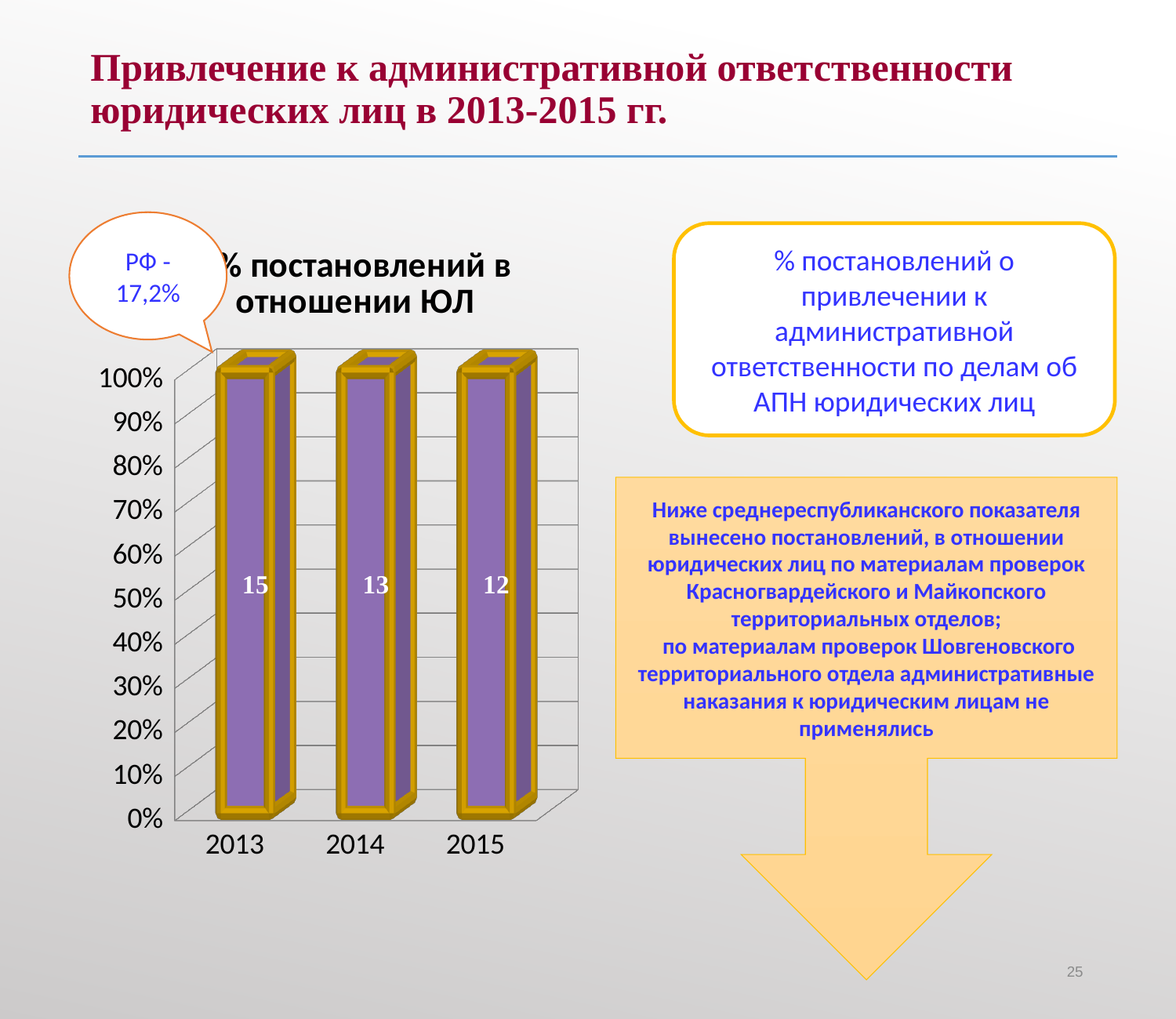
Which year has the highest labelled value in the chart? 2013 What is the difference between the labelled values for 2013 and 2014? 2 What kind of chart is shown on the slide? Bar chart What is the difference between the labelled values for 2013 and 2015? 3 Which year has the larger labelled value, 2014 or 2015? 2014 What is the data label on the bar for 2013? 15 What is the data label on the bar for 2014? 13 Do the labelled values rise or fall from 2013 to 2015? Fall What is the data label on the bar for 2015? 12 How many years (bars) are shown in the chart? 3 Which year has the lowest labelled value in the chart? 2015 What value for РФ is shown in the callout bubble next to the chart? 17,2%